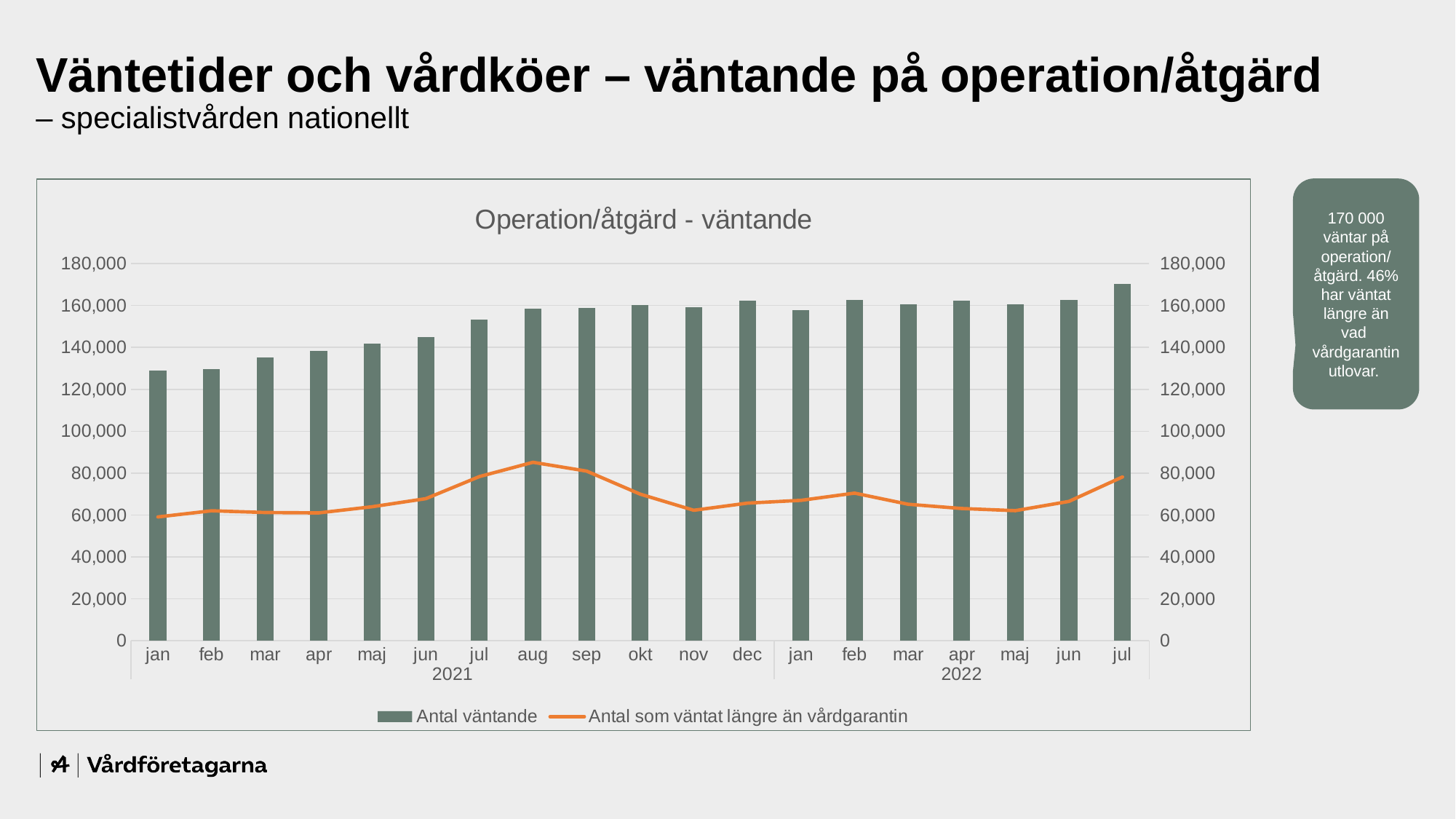
Is the Antal väntande bar for jul 2022 greater or less than 160,000? greater How many series does the chart legend list? 2 Is the Antal väntande bar for jan 2021 greater or less than 140,000? less In which month is the bar for Antal väntande highest? jul 2022 Which series is drawn as an orange line? Antal som väntat längre än vårdgarantin Is the value of Antal som väntat längre än vårdgarantin for aug 2021 greater or less than 80,000? greater In which month does the line Antal som väntat längre än vårdgarantin reach its highest point? aug 2021 How many months are plotted along the x axis? 19 Do the Antal väntande bars generally rise or fall from jan 2021 to jul 2022? rise What kind of chart is shown on the slide? A combined bar and line chart Which is larger, the Antal väntande bar for jul 2022 or for jan 2021? jul 2022 What is the title of the chart? Operation/åtgärd - väntande